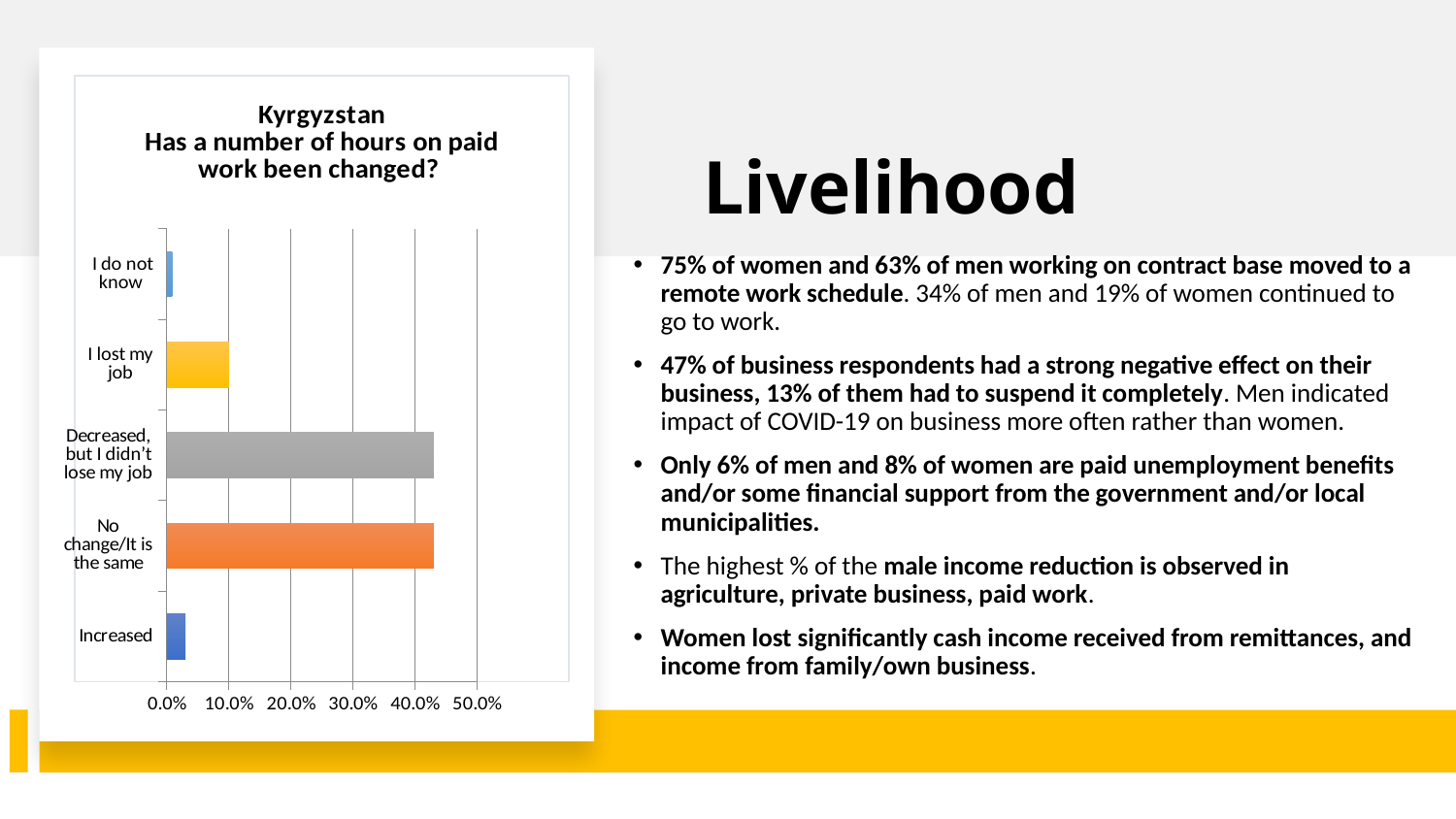
How many categories are shown in the chart? 5 Which is larger, the value for "I lost my job" or the value for "Increased"? I lost my job What is the highest tick value shown on the chart's horizontal axis? 50.0% Is the value for "Decreased, but I didn't lose my job" greater or less than 40.0%? greater Is the value for "I do not know" greater or less than 10.0%? less Which category has the lowest value in the chart? I do not know Is the value for "I lost my job" greater or less than 20.0%? less Which is larger, the value for "Decreased, but I didn't lose my job" or the value for "I do not know"? Decreased, but I didn't lose my job What is the title of the chart? Kyrgyzstan Has a number of hours on paid work been changed? What kind of chart is shown on the slide? bar chart